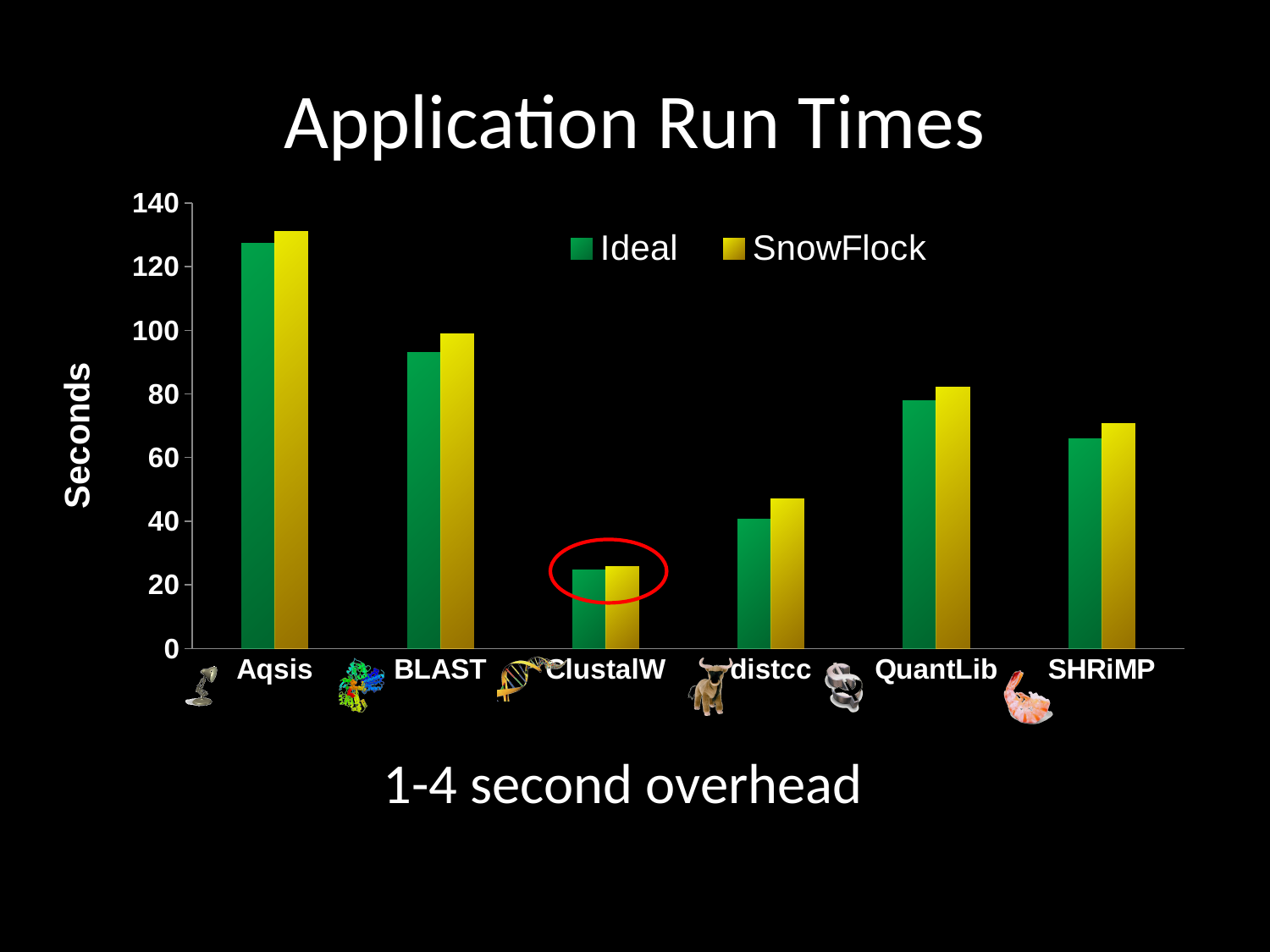
What kind of chart is shown on the slide? bar chart How many applications are shown on the x axis? 6 Is the Ideal value for BLAST greater or less than 100? less Is the SnowFlock value for SHRiMP greater or less than 80? less Which application has the lowest run time? ClustalW Is the Ideal value for Aqsis greater or less than 120? greater Which application has the highest run time? Aqsis Which has the larger Ideal run time, BLAST or QuantLib? BLAST Which has the larger SnowFlock run time, distcc or SHRiMP? SHRiMP How many series does the legend list? 2 What is the label on the y axis? Seconds